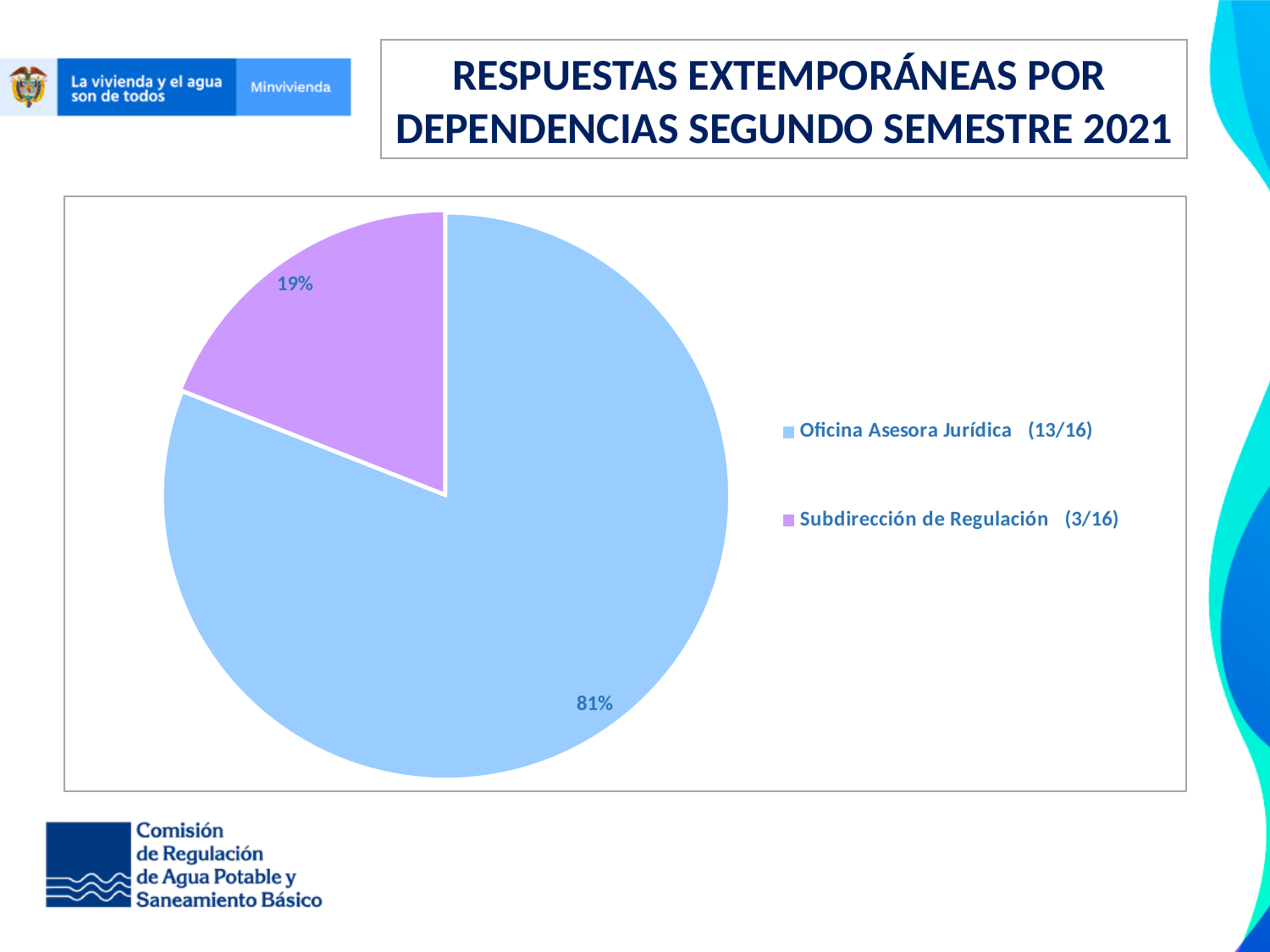
Which dependency has the largest slice of the pie chart? Oficina Asesora Jurídica What percentage share does Subdirección de Regulación have in the pie chart? 19% According to the legend, how many responses out of 16 correspond to Oficina Asesora Jurídica? 13/16 What kind of chart is shown on the slide? pie chart What is the difference in percentage points between the Oficina Asesora Jurídica slice and the Subdirección de Regulación slice? 62 percentage points How many slices does the pie chart have? 2 What percentage share does Oficina Asesora Jurídica have in the pie chart? 81% How many entries does the legend list? 2 According to the legend, how many responses out of 16 correspond to Subdirección de Regulación? 3/16 Which slice is larger: Oficina Asesora Jurídica or Subdirección de Regulación? Oficina Asesora Jurídica What colour is the slice for Subdirección de Regulación? purple Which dependency has the smallest slice of the pie chart? Subdirección de Regulación